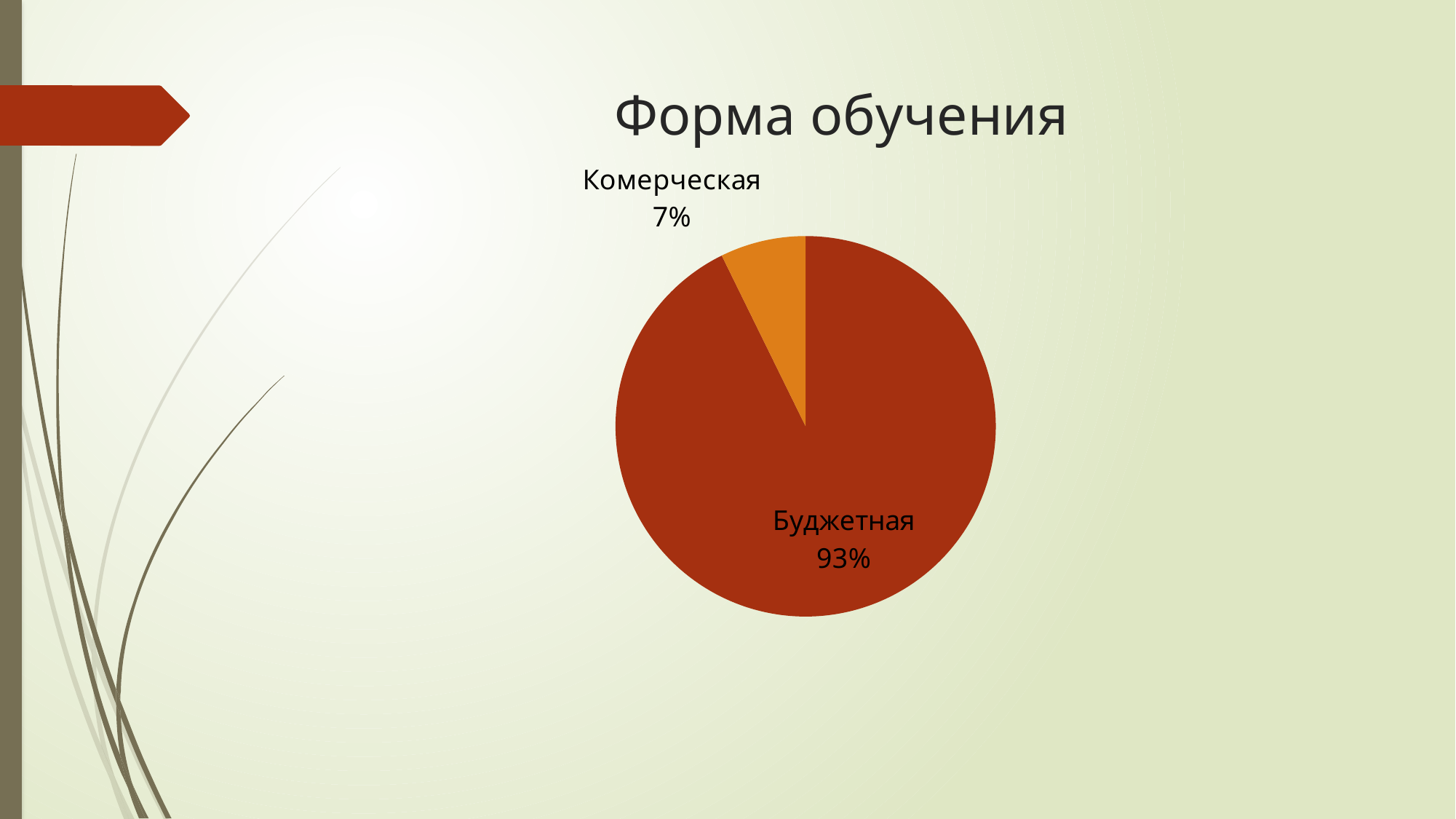
What share of the pie does Буджетная take? 93% Which slice of the pie is the largest? Буджетная Which slice of the pie is the smallest? Комерческая How many slices does the pie chart have? 2 Which is larger, the share for Буджетная or the share for Комерческая? Буджетная What is the title of the chart? Форма обучения What is the difference in percentage points between Буджетная and Комерческая? 86 What colour is the Комерческая slice? orange What kind of chart is shown on the slide? pie chart What share of the pie does Комерческая take? 7%